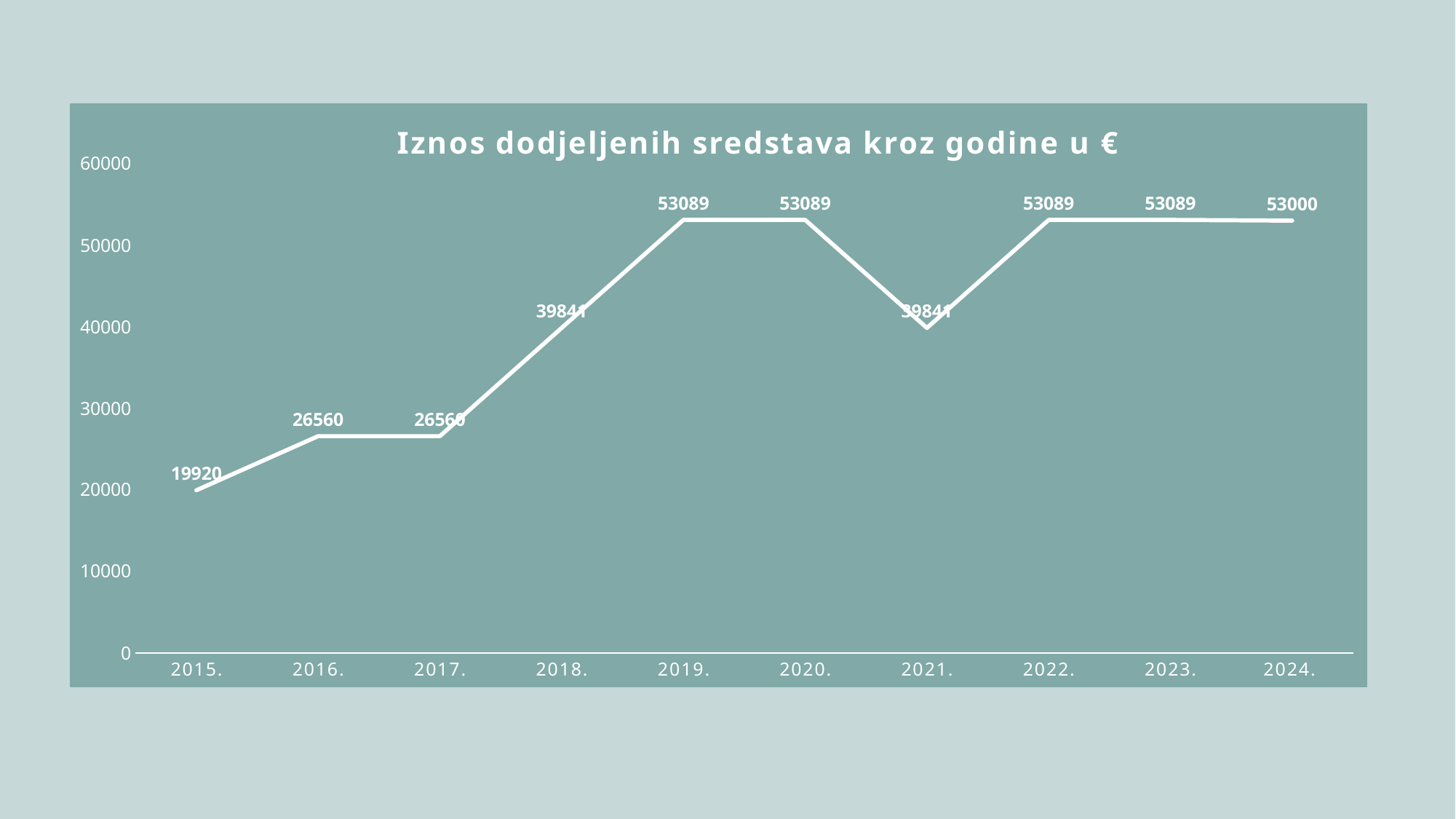
Which is larger, the value for 2021. or the value for 2022.? 2022. What is the title of the chart? Iznos dodjeljenih sredstava kroz godine u € What is the value for 2024.? 53000 Does the value rise or fall from 2020. to 2021.? fall What is the difference between the values for 2016. and 2015.? 6640 What is the value for 2018.? 39841 Which year has the lowest value? 2015. What type of chart is shown on the slide? line chart How many years are plotted on the x axis? 10 Is the value for 2017. greater or less than 30000? less What is the value for 2015.? 19920 What is the difference between the values for 2019. and 2018.? 13248